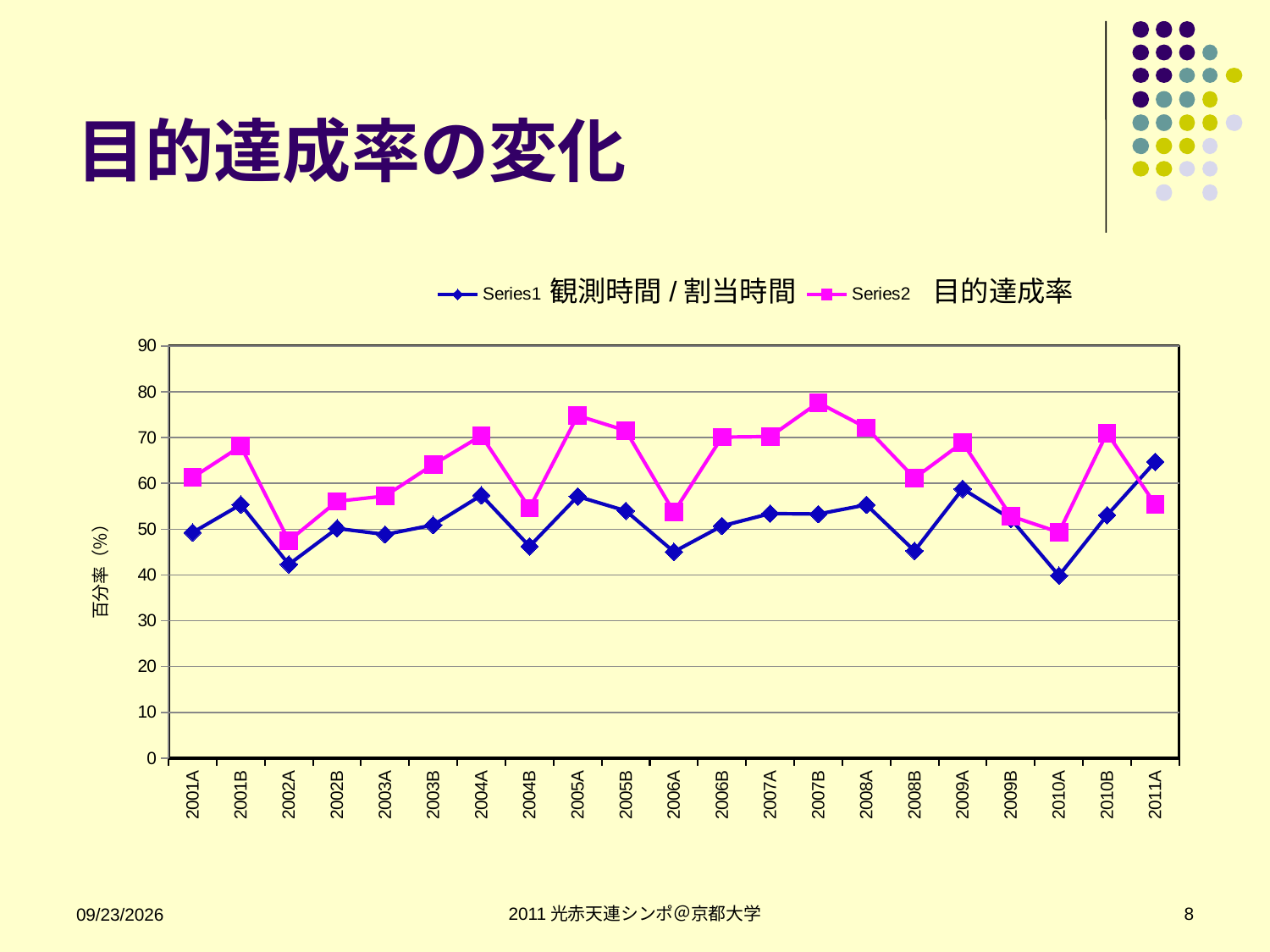
Which category has the highest value for Series1 (観測時間 / 割当時間)? 2011A Is the value of Series2 (目的達成率) for 2002A greater or less than 50? less Is the value of Series1 (観測時間 / 割当時間) for 2011A greater or less than 60? greater Is the value of Series2 (目的達成率) for 2007B greater or less than 70? greater How many categories are shown on the x axis? 21 At 2001A, which series has the larger value, Series1 or Series2? Series2 At 2011A, which series has the larger value, Series1 or Series2? Series1 What is the title of the slide containing the chart? 目的達成率の変化 How many series does the legend list? 2 What is the label of the y axis? 百分率 (%) What kind of chart is shown on the slide? line chart